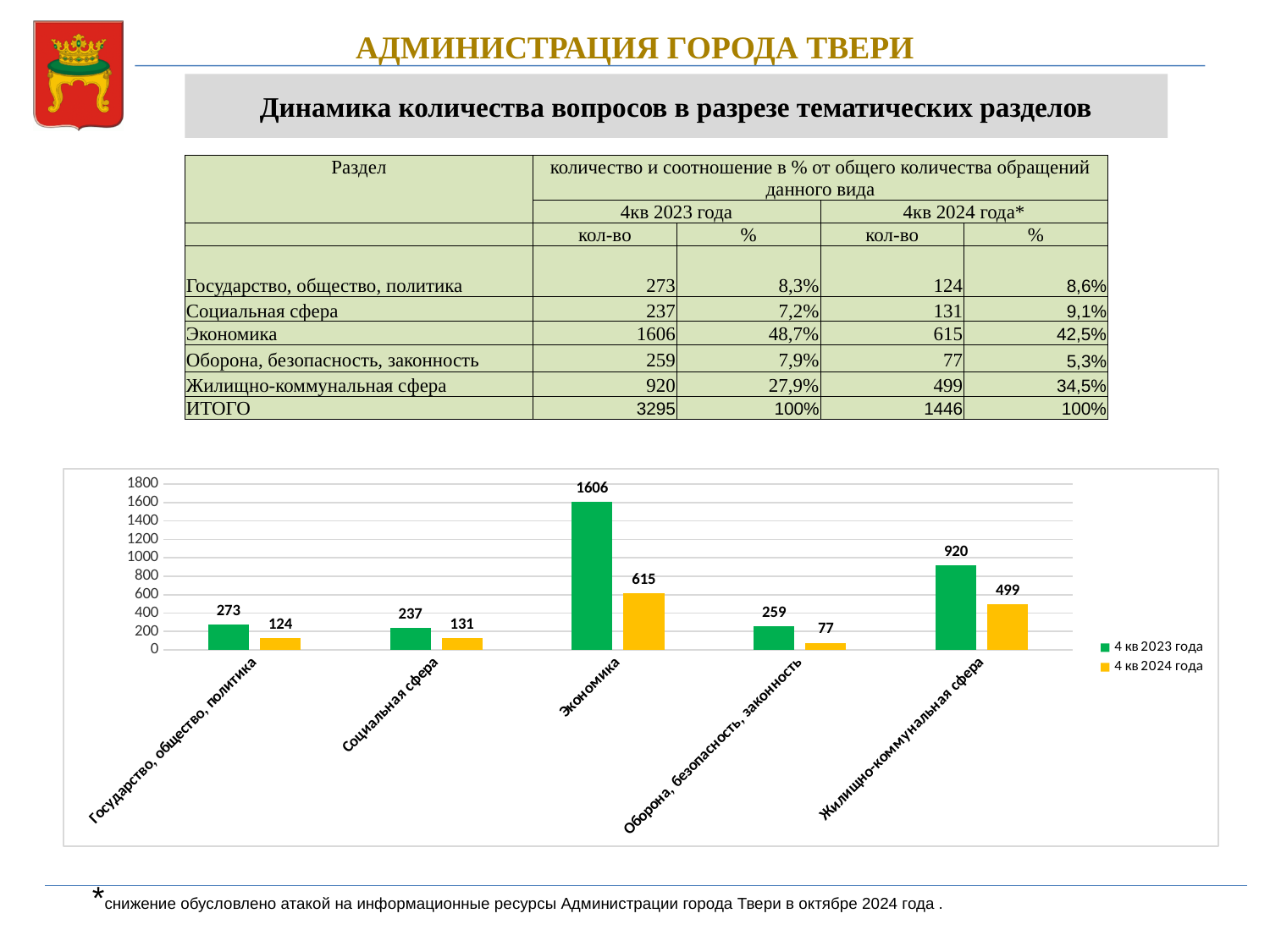
What is the difference between the 4 кв 2023 года and 4 кв 2024 года values for Экономика? 991 Which category has the highest value in the 4 кв 2023 года series? Экономика What is the value for Жилищно-коммунальная сфера in the 4 кв 2024 года series? 499 Is the 4 кв 2023 года value for Жилищно-коммунальная сфера greater or less than 800? greater How many categories are shown on the x axis of the chart? 5 What type of chart is shown on the slide? bar chart Which is larger: the 4 кв 2024 года value for Социальная сфера or for Государство, общество, политика? Социальная сфера Which colour represents the 4 кв 2024 года series in the chart? yellow How many series does the chart legend list? 2 What is the value for Экономика in the 4 кв 2023 года series? 1606 What is the value for Оборона, безопасность, законность in the 4 кв 2024 года series? 77 Which category has the lowest value in the 4 кв 2024 года series? Оборона, безопасность, законность